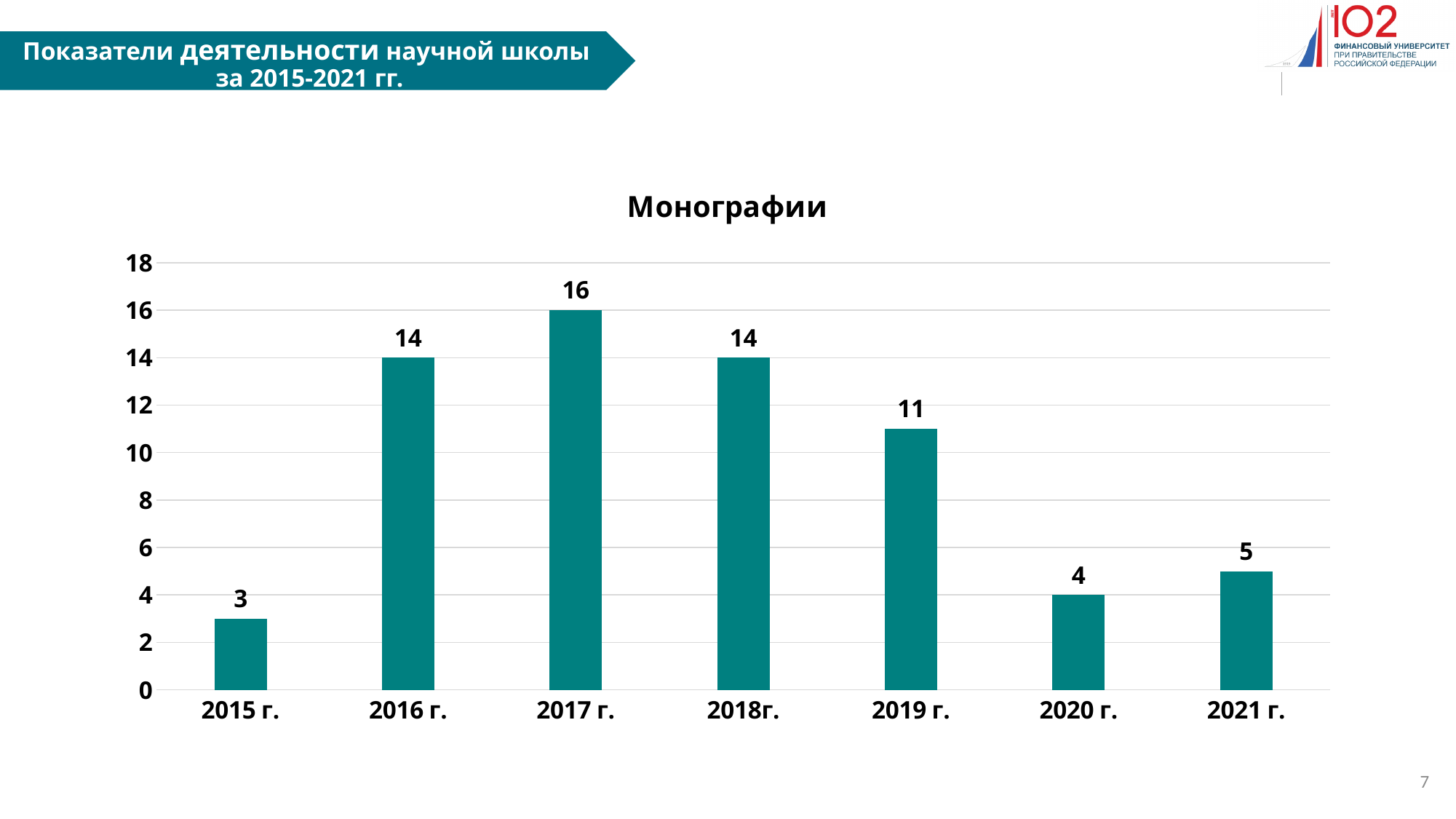
Is the value for 2018г. in the Монографии chart greater or less than 10? greater What kind of chart is the Монографии chart? bar chart What is the difference between the values for 2017 г. and 2020 г. in the Монографии chart? 12 What is the value for 2021 г. in the Монографии chart? 5 What is the title of the chart on the slide? Монографии Which is larger in the Монографии chart, the value for 2019 г. or the value for 2021 г.? 2019 г. What is the value for 2015 г. in the Монографии chart? 3 Which year has the highest value in the Монографии chart? 2017 г. What is the value for 2019 г. in the Монографии chart? 11 How many years are shown on the x axis of the Монографии chart? 7 Which year has the lowest value in the Монографии chart? 2015 г. What is the value for 2017 г. in the Монографии chart? 16